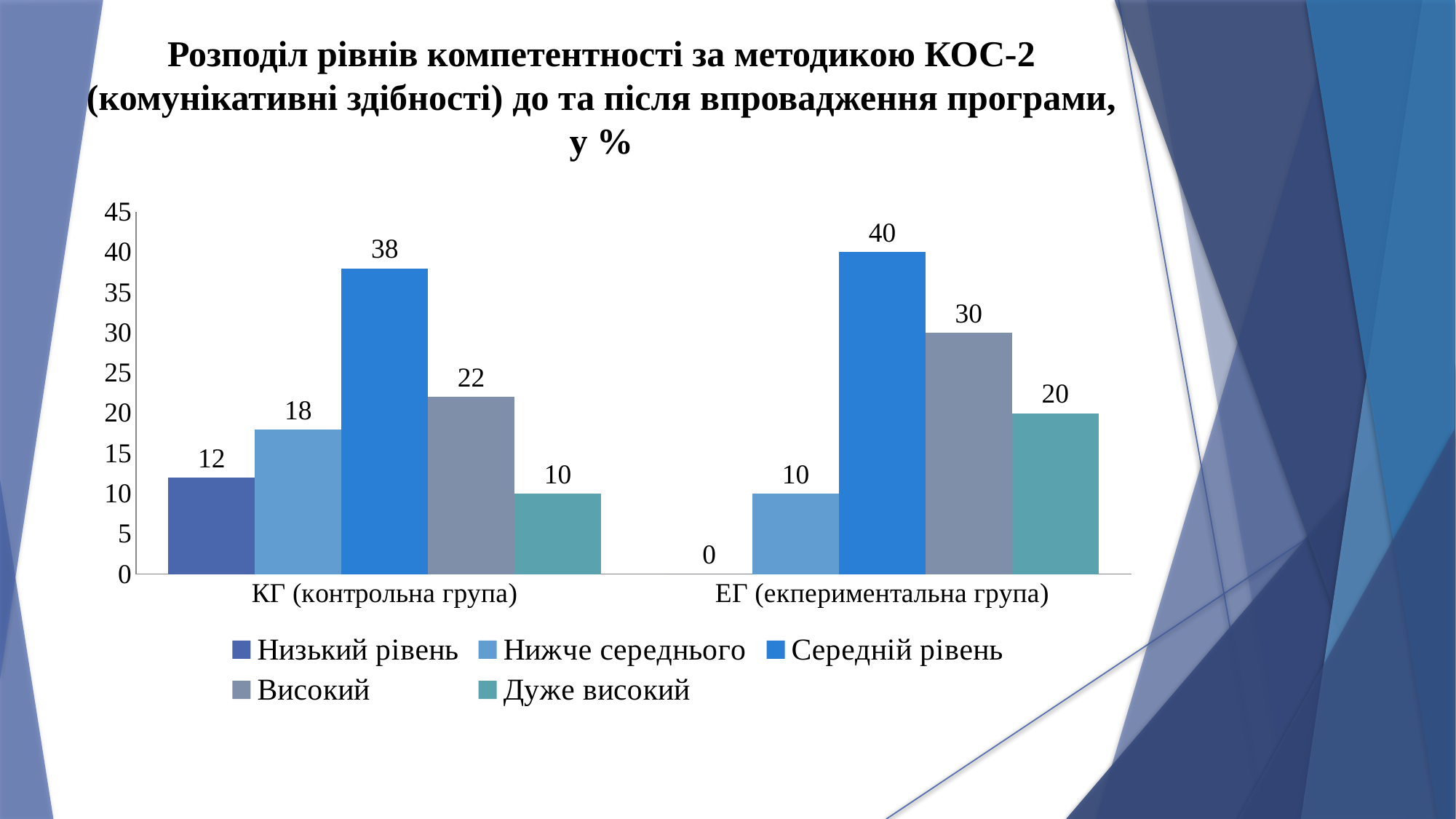
Which series has the lowest value in the КГ (контрольна група) category? Дуже високий What is the value for Середній рівень in the КГ (контрольна група) category? 38 Which is larger: Нижче середнього for КГ (контрольна група) or for ЕГ (екпериментальна група)? КГ (контрольна група) How many series does the legend list? 5 What is the value for Дуже високий in the ЕГ (екпериментальна група) category? 20 Which series has the highest value in the ЕГ (екпериментальна група) category? Середній рівень What kind of chart is shown on the slide? Bar chart What is the difference between the Високий values for ЕГ (екпериментальна група) and КГ (контрольна група)? 8 What is the total of the five values for the КГ (контрольна група) category? 100 What is the maximum value shown on the vertical axis? 45 How many categories are shown on the x axis? 2 What is the value for Низький рівень in the ЕГ (екпериментальна група) category? 0